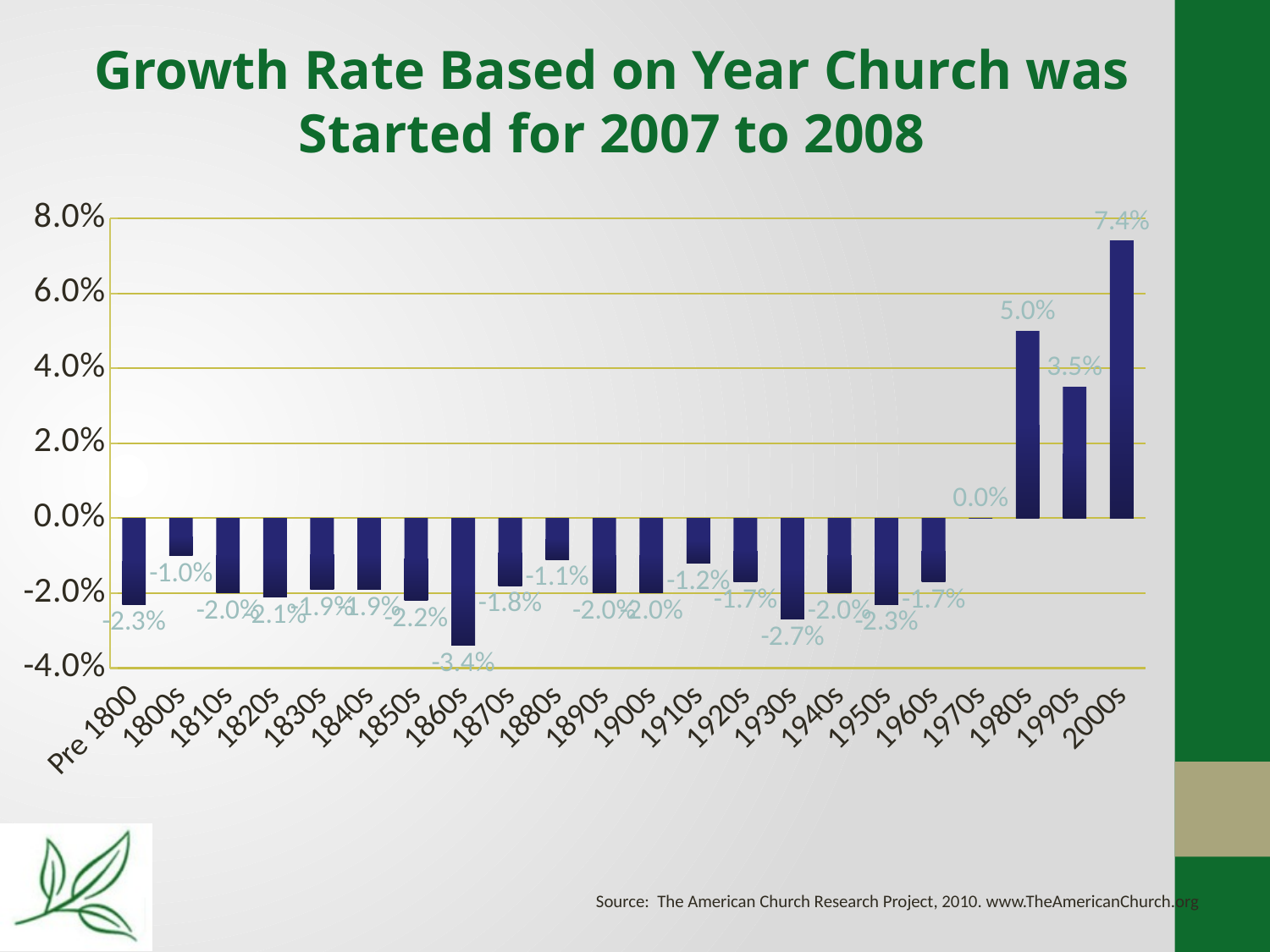
Which decade has the lowest growth rate? 1860s What is the growth rate for churches started in the 1930s? -2.7% Which has a higher growth rate, the 1990s or the 1980s? 1980s What is the growth rate for churches started in the 1970s? 0.0% Which decade has the highest growth rate? 2000s What is the growth rate for churches started in the 1980s? 5.0% Is the growth rate for the 1990s greater or less than 4.0%? less What is the growth rate for churches started in the 2000s? 7.4% What kind of chart is shown on the slide? Bar chart How many categories are shown on the x axis? 22 What is the difference between the growth rate for the 2000s and the 1980s? 2.4% What is the growth rate for churches started in the 1860s? -3.4%